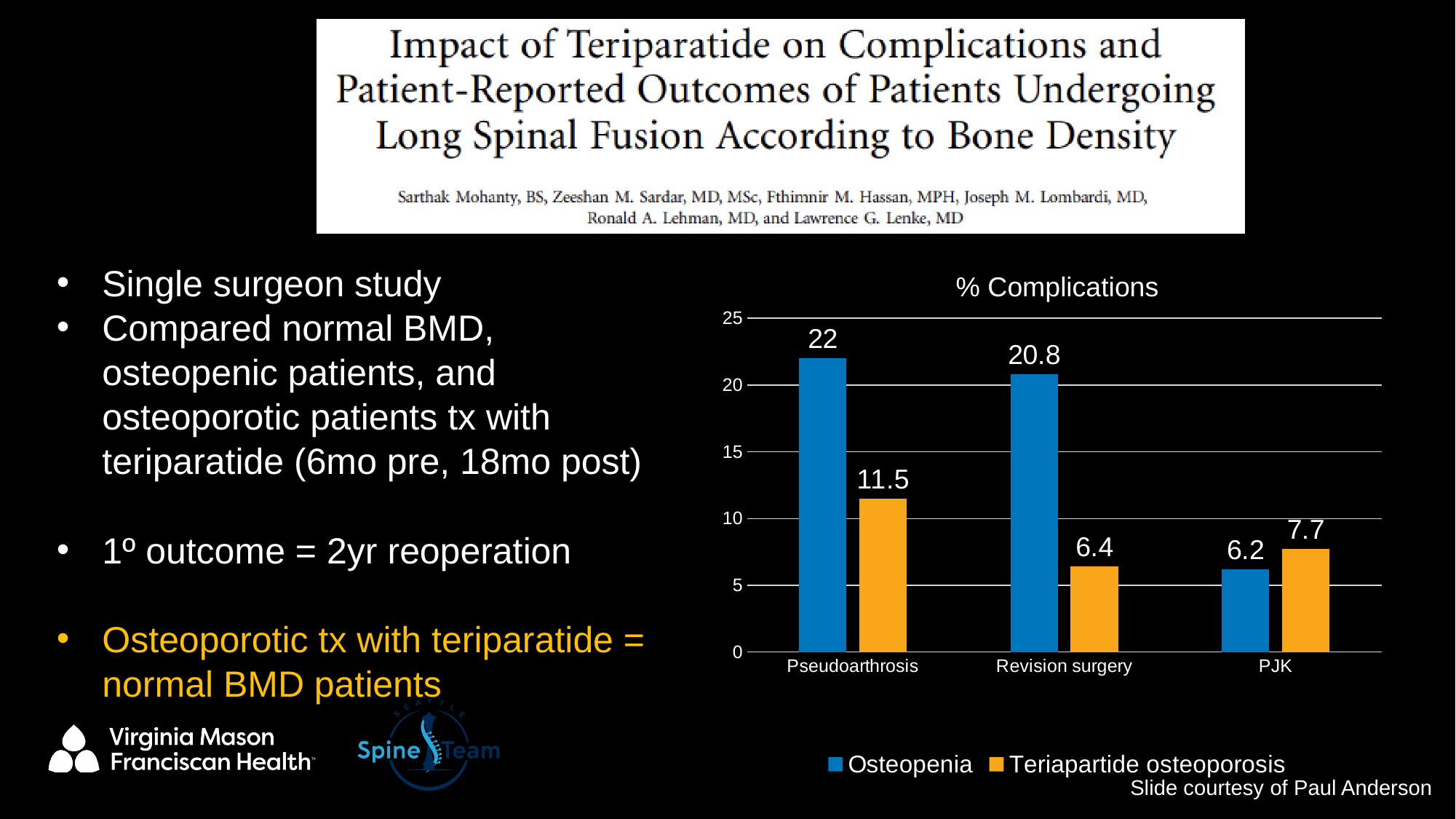
What kind of chart is shown? bar chart What is the title of the chart? % Complications What is the Osteopenia value for Pseudoarthrosis? 22 What is the Teriapartide osteoporosis value for PJK? 7.7 How many categories are shown on the x axis? 3 Which category has the lowest Teriapartide osteoporosis value? Revision surgery What is the Teriapartide osteoporosis value for Revision surgery? 6.4 For PJK, which series has the larger value, Osteopenia or Teriapartide osteoporosis? Teriapartide osteoporosis What is the difference between the Osteopenia and Teriapartide osteoporosis values for Pseudoarthrosis? 10.5 Is the Osteopenia value for Revision surgery greater or less than 15? greater Which category has the highest Osteopenia value? Pseudoarthrosis How many series does the legend list? 2